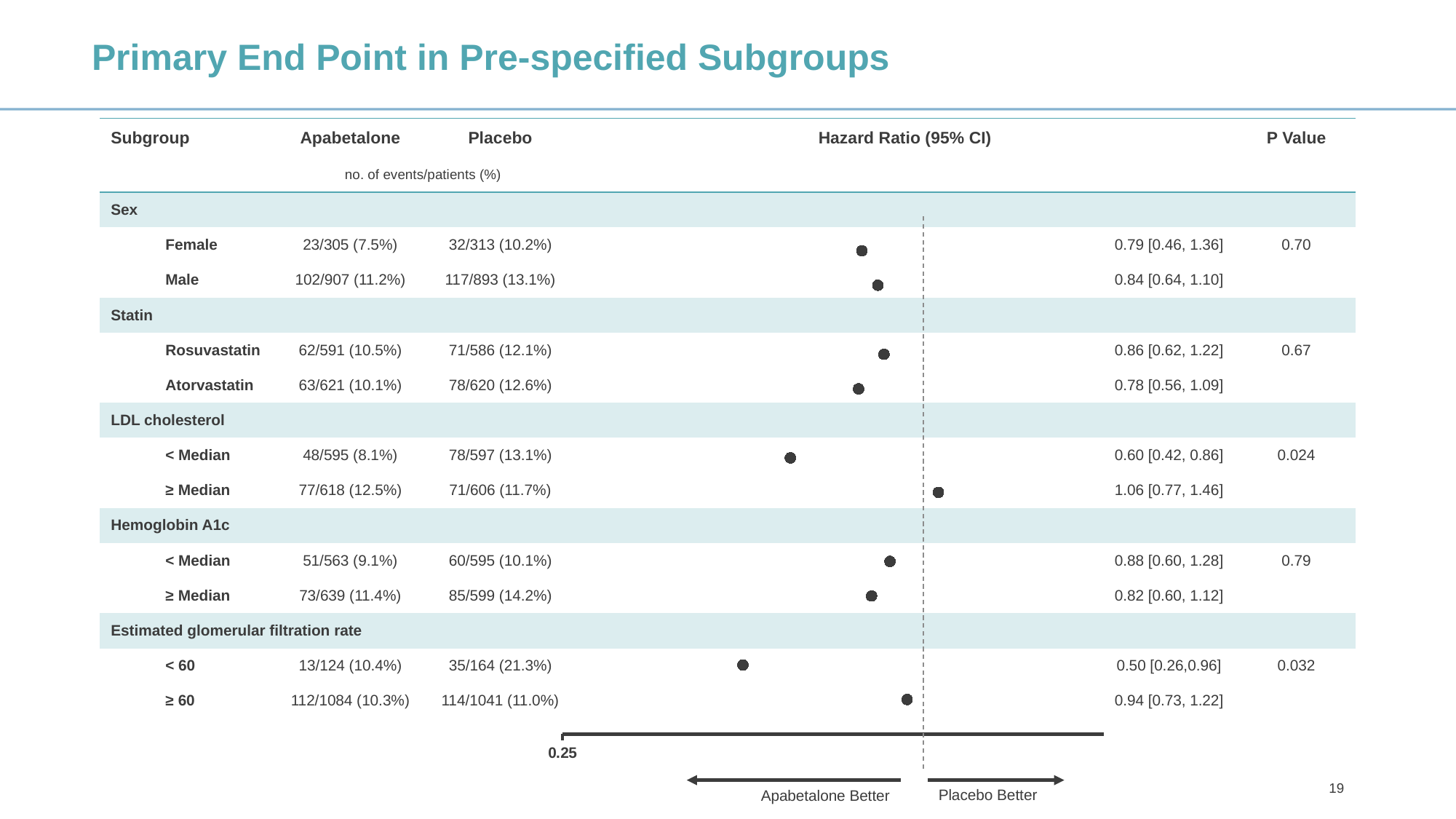
What kind of chart is shown on the slide? Forest plot What is the title of the slide? Primary End Point in Pre-specified Subgroups What is the hazard ratio for the Estimated glomerular filtration rate < 60 subgroup? 0.50 [0.26,0.96] What is the P value for the LDL cholesterol subgroup comparison? 0.024 What is the hazard ratio for the Female subgroup? 0.79 [0.46, 1.36] How many subgroup rows are plotted as points in the forest plot? 10 Which side of the dashed line is labelled 'Apabetalone Better'? Left What is the number of events/patients for Apabetalone in the Male subgroup? 102/907 (11.2%) Which subgroup has the highest hazard ratio point estimate? LDL cholesterol ≥ Median Which subgroup has the lowest hazard ratio point estimate? Estimated glomerular filtration rate < 60 What is the difference between the hazard ratio point estimates for LDL cholesterol ≥ Median and LDL cholesterol < Median? 0.46 Which has the larger hazard ratio point estimate, Rosuvastatin or Atorvastatin? Rosuvastatin